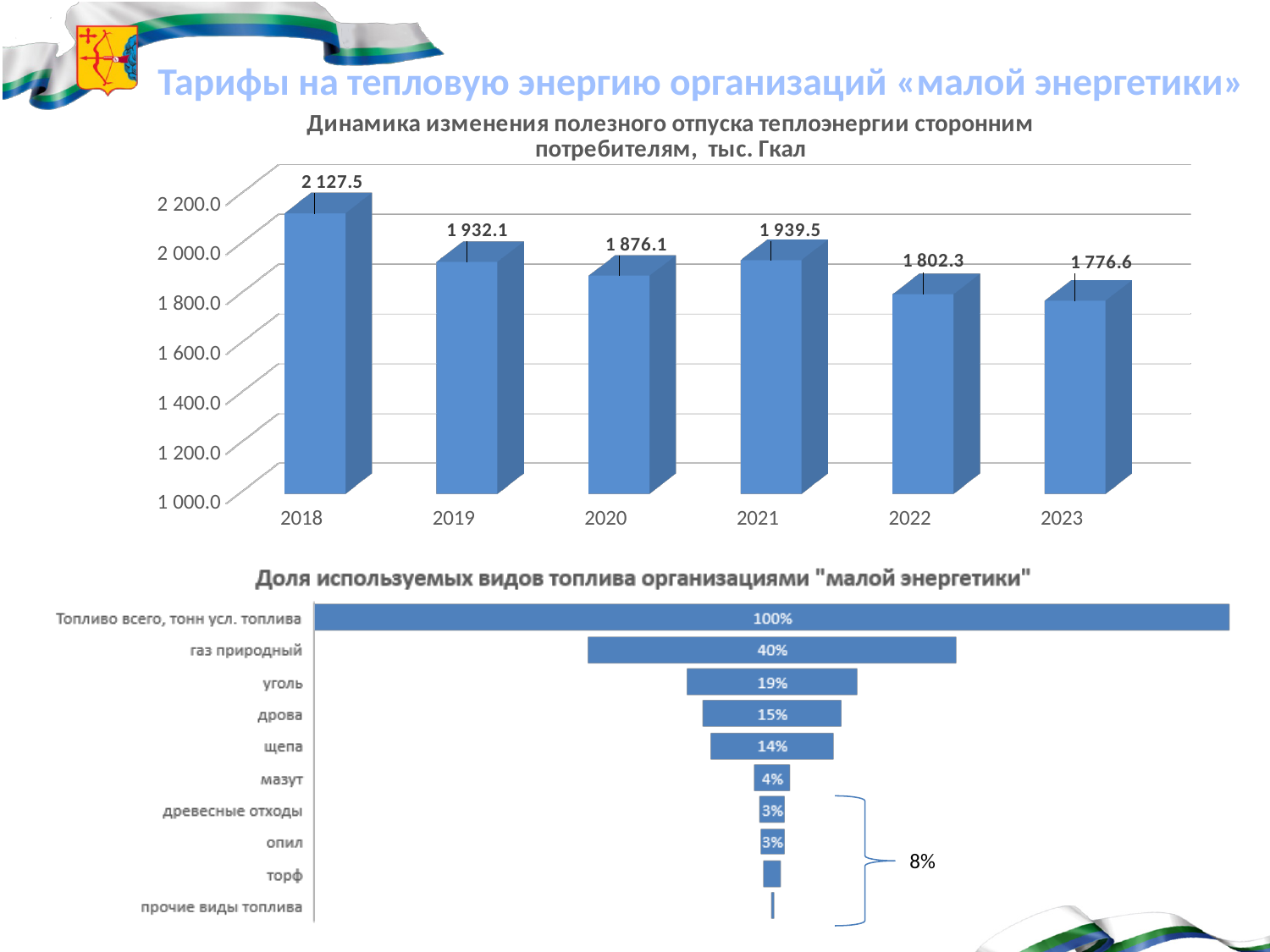
In the top chart (Динамика изменения полезного отпуска теплоэнергии), which year has the highest value? 2018 In the top chart (Динамика изменения полезного отпуска теплоэнергии), what is the value for 2018? 2 127.5 In the top chart (Динамика изменения полезного отпуска теплоэнергии), which year has the lowest value? 2023 In the bottom chart (Доля используемых видов топлива), what is the difference between the shares of газ природный and мазут? 36% In the bottom chart (Доля используемых видов топлива), what is the share for газ природный? 40% In the top chart (Динамика изменения полезного отпуска теплоэнергии), how many years are shown? 6 In the bottom chart (Доля используемых видов топлива), which is larger: дрова or щепа? дрова In the top chart (Динамика изменения полезного отпуска теплоэнергии), what is the difference between the 2018 and 2019 values? 195.4 In the top chart (Динамика изменения полезного отпуска теплоэнергии), which is larger: the value for 2020 or the value for 2021? 2021 In the bottom chart (Доля используемых видов топлива), what is the share for уголь? 19% What type of chart is the top chart (Динамика изменения полезного отпуска теплоэнергии)? Bar chart In the top chart (Динамика изменения полезного отпуска теплоэнергии), what is the value for 2023? 1 776.6